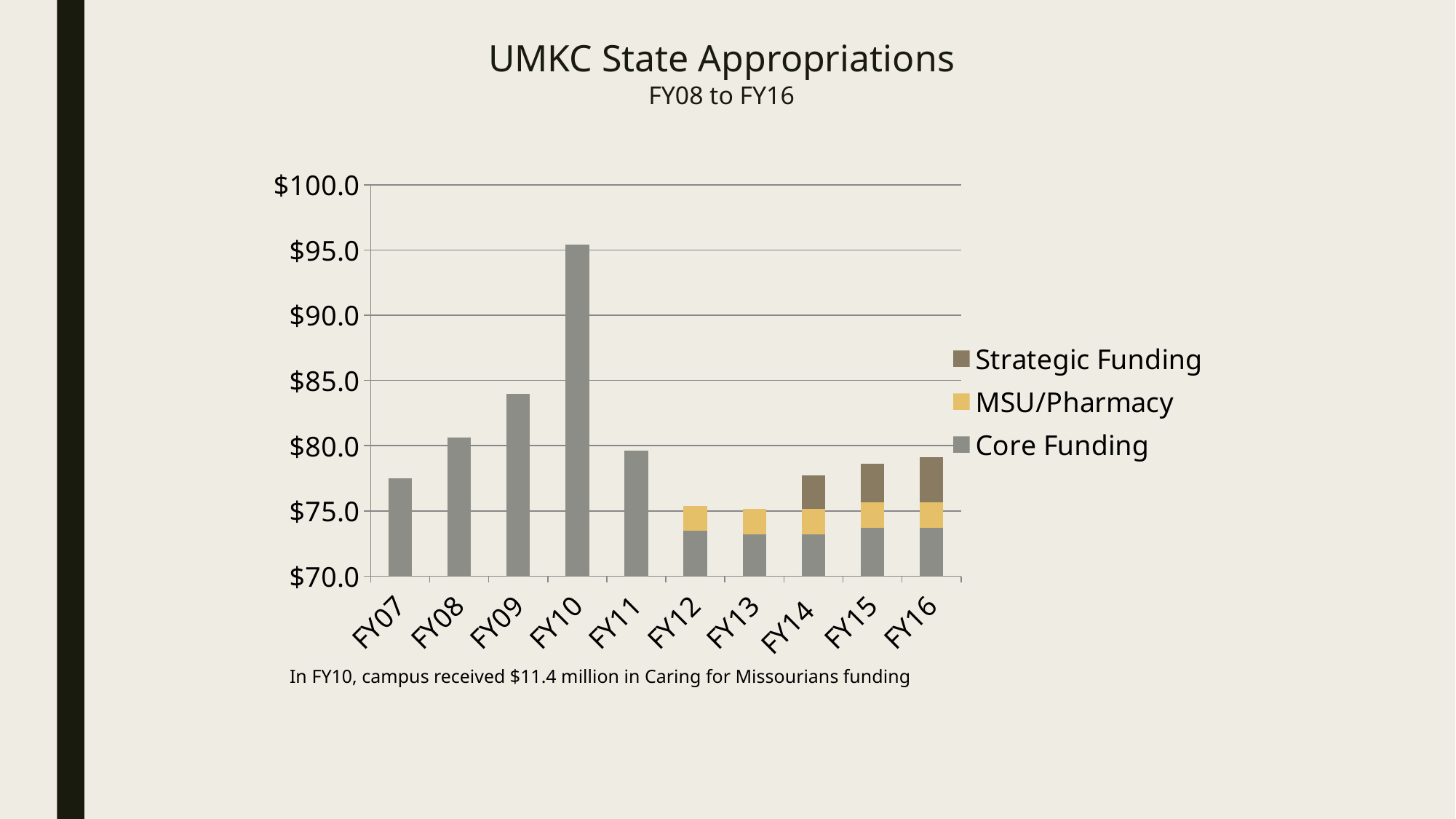
How many fiscal years are shown on the x axis of the chart? 10 How many series does the chart's legend list? 3 Is the value for FY09 greater or less than $80.0? greater Is the Core Funding value for FY13 greater or less than $75.0? less Which fiscal year has the highest total state appropriation? FY10 Is the value for FY07 greater or less than $80.0? less Do the totals rise or fall from FY07 to FY10? rise Which is larger, the total for FY09 or the total for FY08? FY09 Which is larger, the total for FY16 or the total for FY12? FY16 What kind of chart is shown on the slide? bar chart Which legend entry is shown in yellow? MSU/Pharmacy